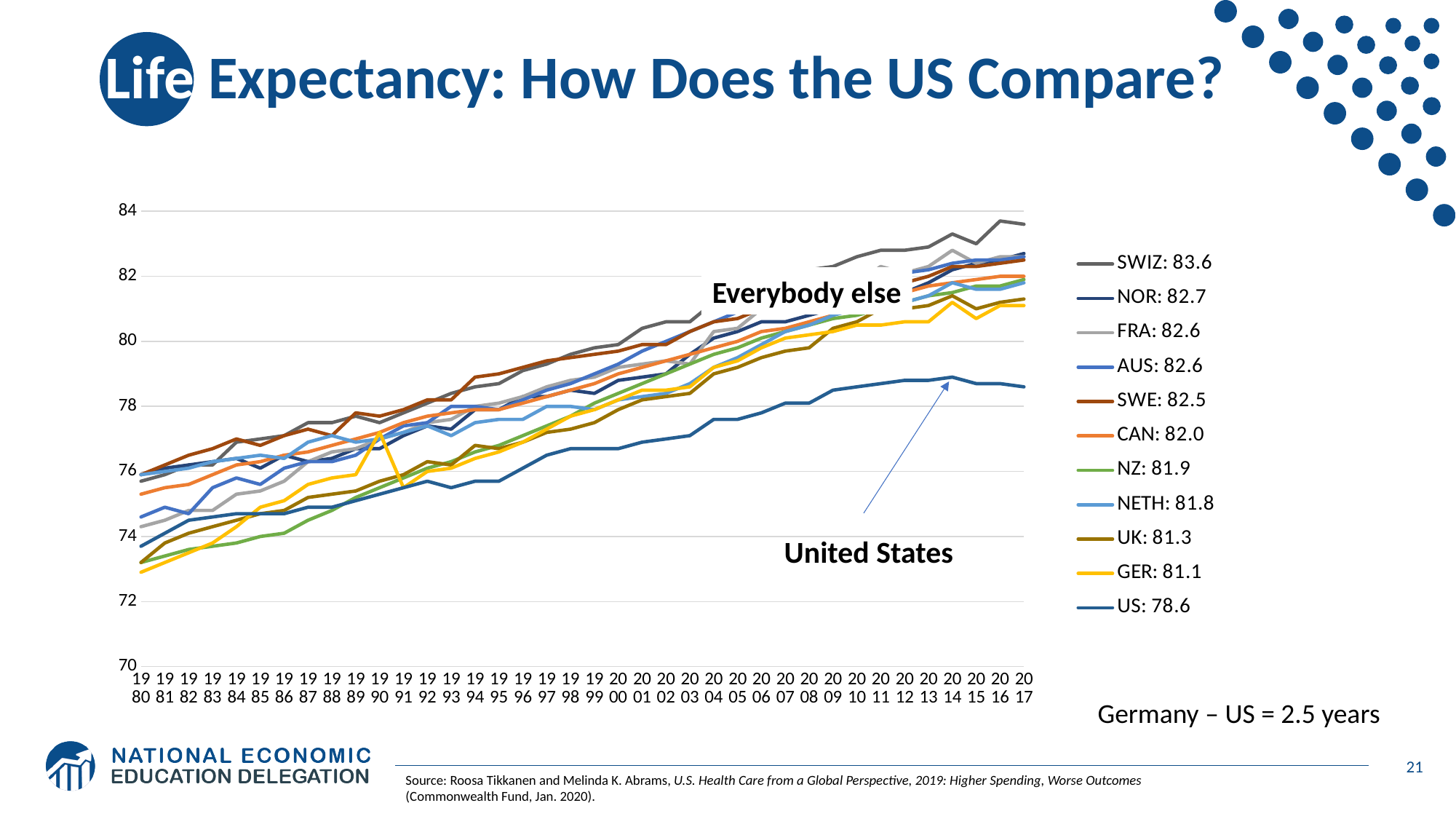
What kind of chart is shown on the slide? line chart Is the value for US in 1980 greater or less than 74? less Does the US line generally rise or fall from 1980 to 2017? rise How many series does the legend list? 11 What value is shown in the legend for SWIZ? 83.6 Which country has the highest value in the legend? SWIZ According to the text on the slide, what is the gap between Germany and the US? 2.5 years Which country has the lowest value in the legend? US Which has a higher legend value, CAN or UK? CAN What value is shown in the legend for US? 78.6 What value is shown in the legend for GER? 81.1 What is the difference between the legend values for SWIZ and US? 5.0